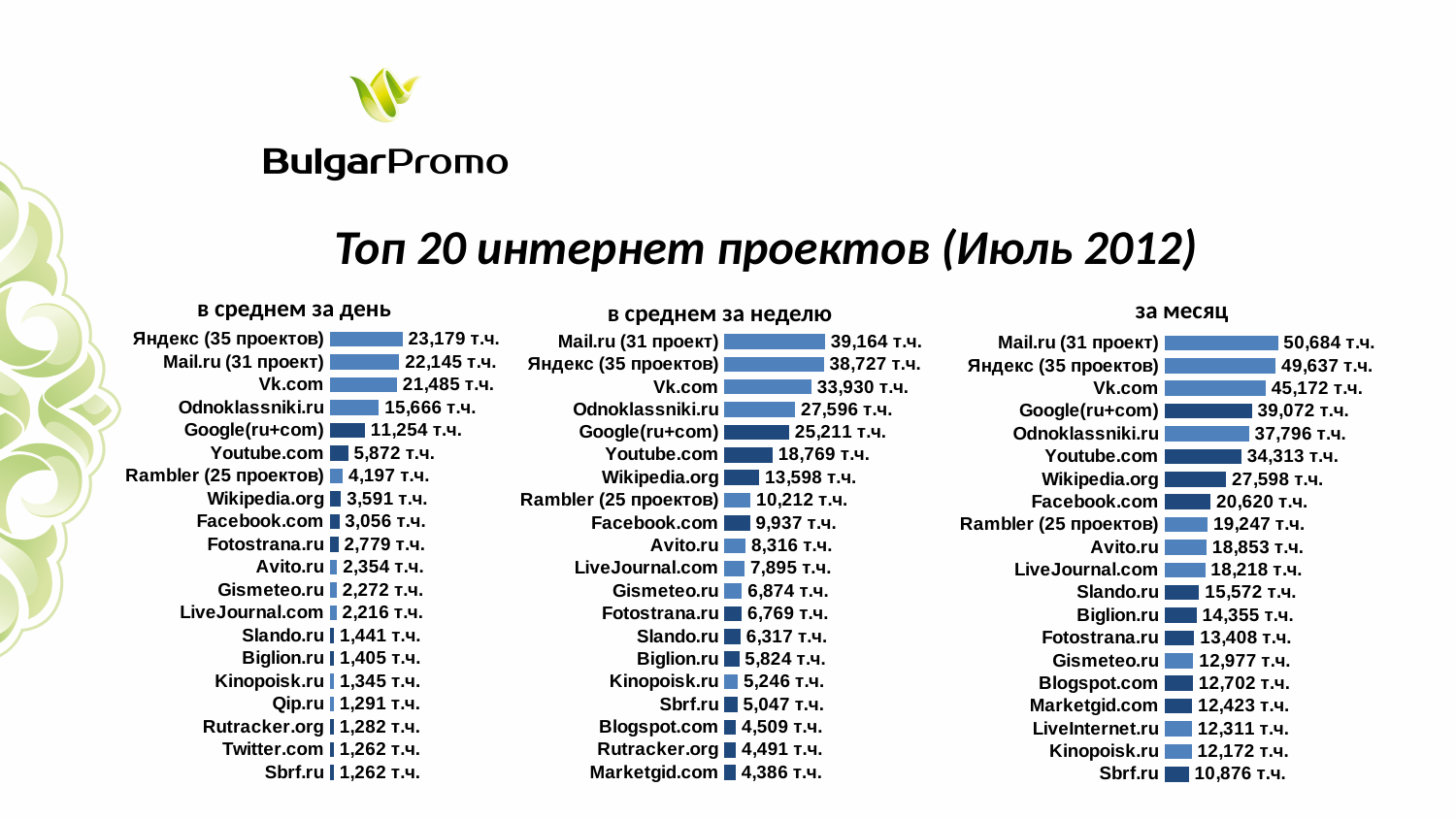
In the chart 'в среднем за неделю', which category has the highest value? Mail.ru (31 проект) In the chart 'в среднем за день', what is the difference between Яндекс (35 проектов) and Mail.ru (31 проект)? 1,034 т.ч. In the chart 'в среднем за день', which category has the highest value? Яндекс (35 проектов) What kind of chart is 'за месяц'? Bar chart In the chart 'за месяц', which is larger: Google(ru+com) or Odnoklassniki.ru? Google(ru+com) In the chart 'за месяц', which category has the lowest value? Sbrf.ru In the chart 'в среднем за неделю', what is the value for Youtube.com? 18,769 т.ч. How many categories are shown in the chart 'в среднем за день'? 20 In the chart 'в среднем за день', what is the value for Яндекс (35 проектов)? 23,179 т.ч. In the chart 'за месяц', what is the value for Google(ru+com)? 39,072 т.ч. What is the title of the slide? Топ 20 интернет проектов (Июль 2012) In the chart 'в среднем за неделю', what is the difference between Vk.com and Odnoklassniki.ru? 6,334 т.ч.